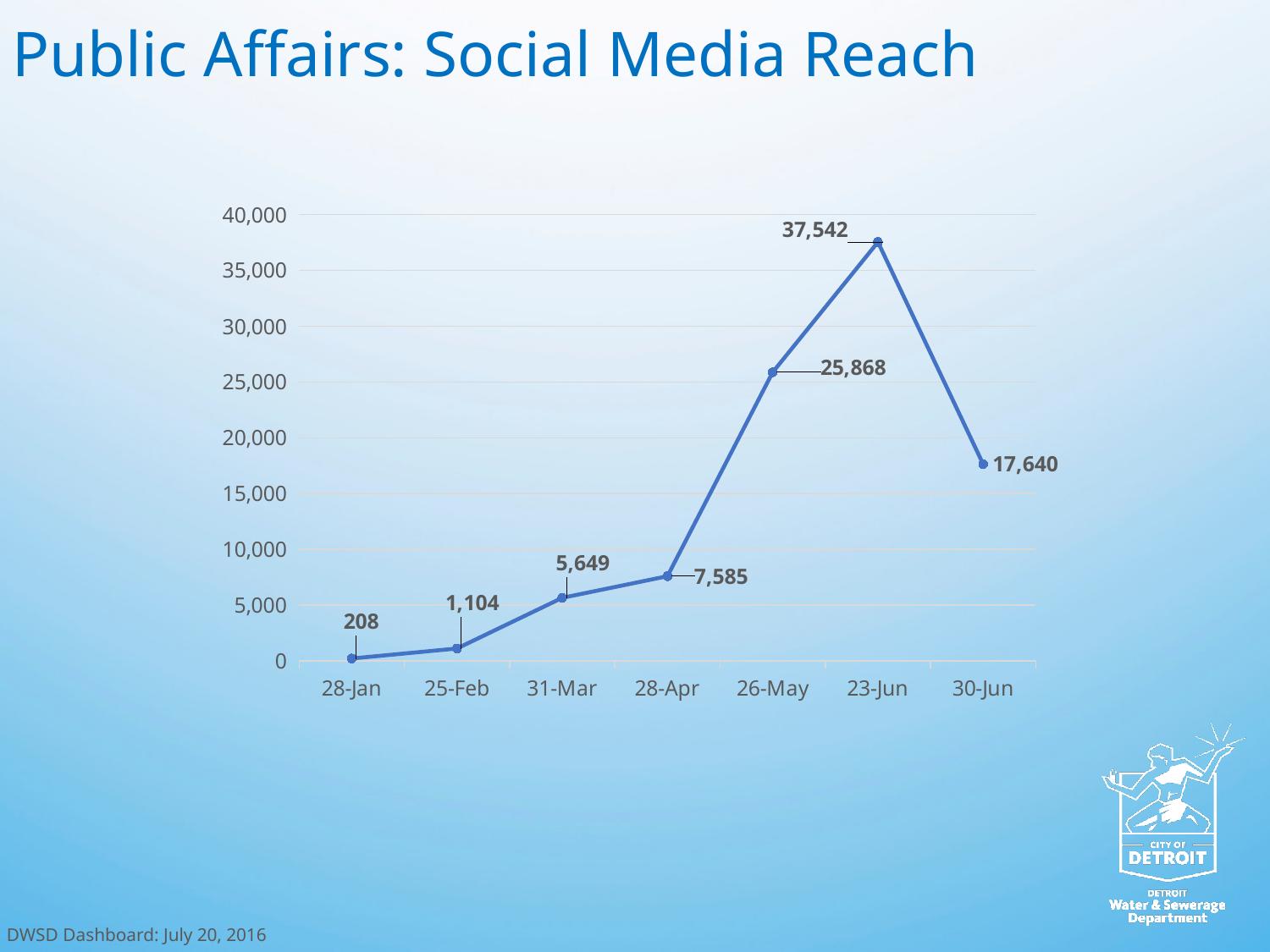
Does the social media reach rise or fall from 28-Jan to 23-Jun? Rise What is the social media reach value for 30-Jun? 17,640 What is the difference between the values for 28-Apr and 31-Mar? 1,936 How many data points are plotted on the chart? 7 What is the social media reach value for 26-May? 25,868 Which date has the lowest social media reach? 28-Jan What is the social media reach value for 28-Jan? 208 Which is larger, the value for 26-May or the value for 28-Apr? 26-May What is the difference between the values for 23-Jun and 30-Jun? 19,902 What kind of chart is shown on the slide? Line chart What is the social media reach value for 23-Jun? 37,542 Which date has the highest social media reach? 23-Jun